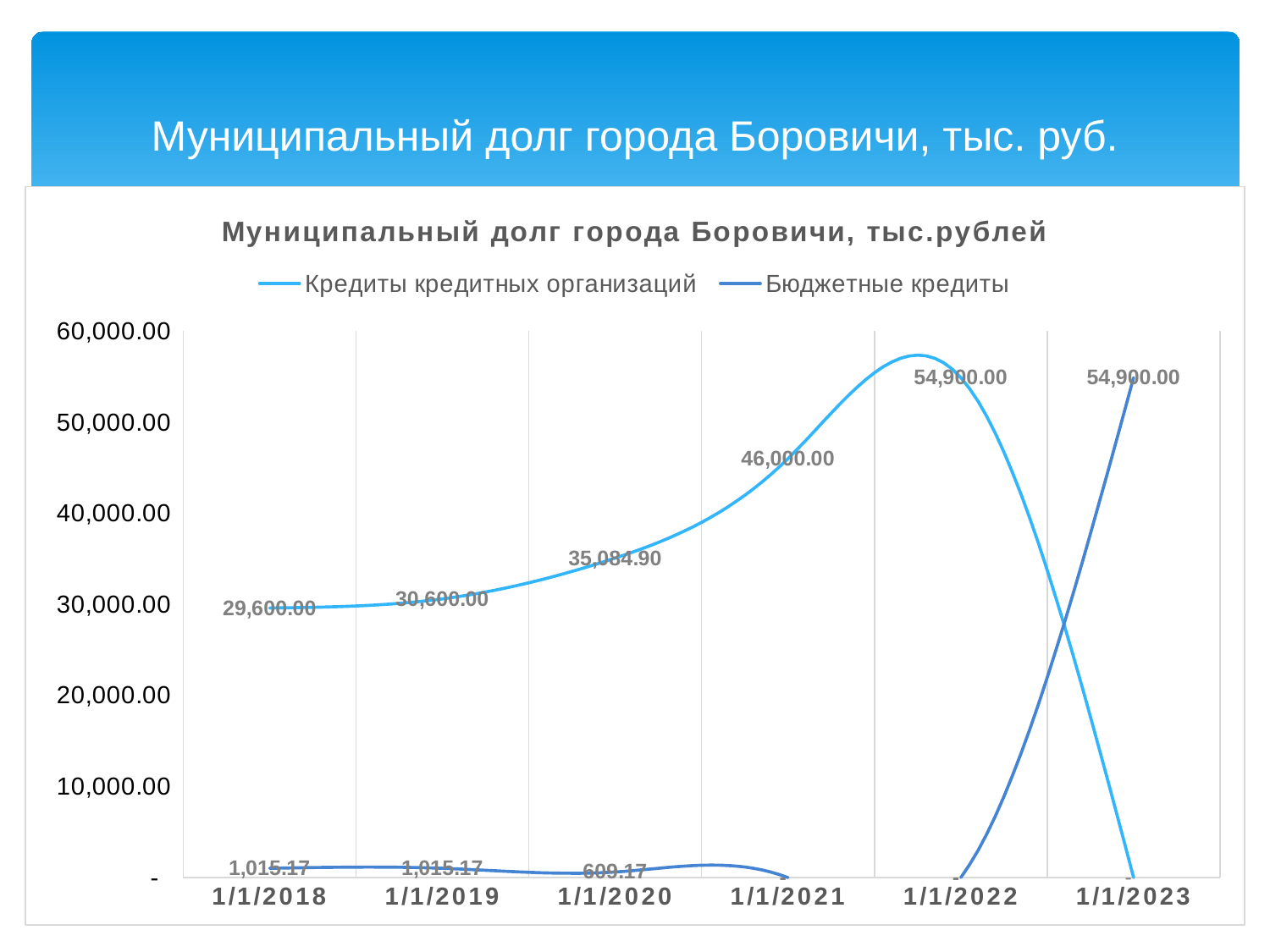
On 1/1/2018, which series has the larger value, Кредиты кредитных организаций or Бюджетные кредиты? Кредиты кредитных организаций What is the difference between Кредиты кредитных организаций on 1/1/2021 and on 1/1/2020? 10,915.10 What is the value of Бюджетные кредиты on 1/1/2020? 609.17 On which date does Кредиты кредитных организаций reach its highest labelled value? 1/1/2022 Is the value of Кредиты кредитных организаций on 1/1/2023 greater or less than 10,000.00? less What is the value of Кредиты кредитных организаций on 1/1/2018? 29,600.00 What is the value of Кредиты кредитных организаций on 1/1/2021? 46,000.00 What is the value of Бюджетные кредиты on 1/1/2023? 54,900.00 How many series does the legend list? 2 What kind of chart is shown on the slide? line chart By how much did Кредиты кредитных организаций increase from 1/1/2018 to 1/1/2019? 1,000.00 How many dates are shown on the x axis? 6